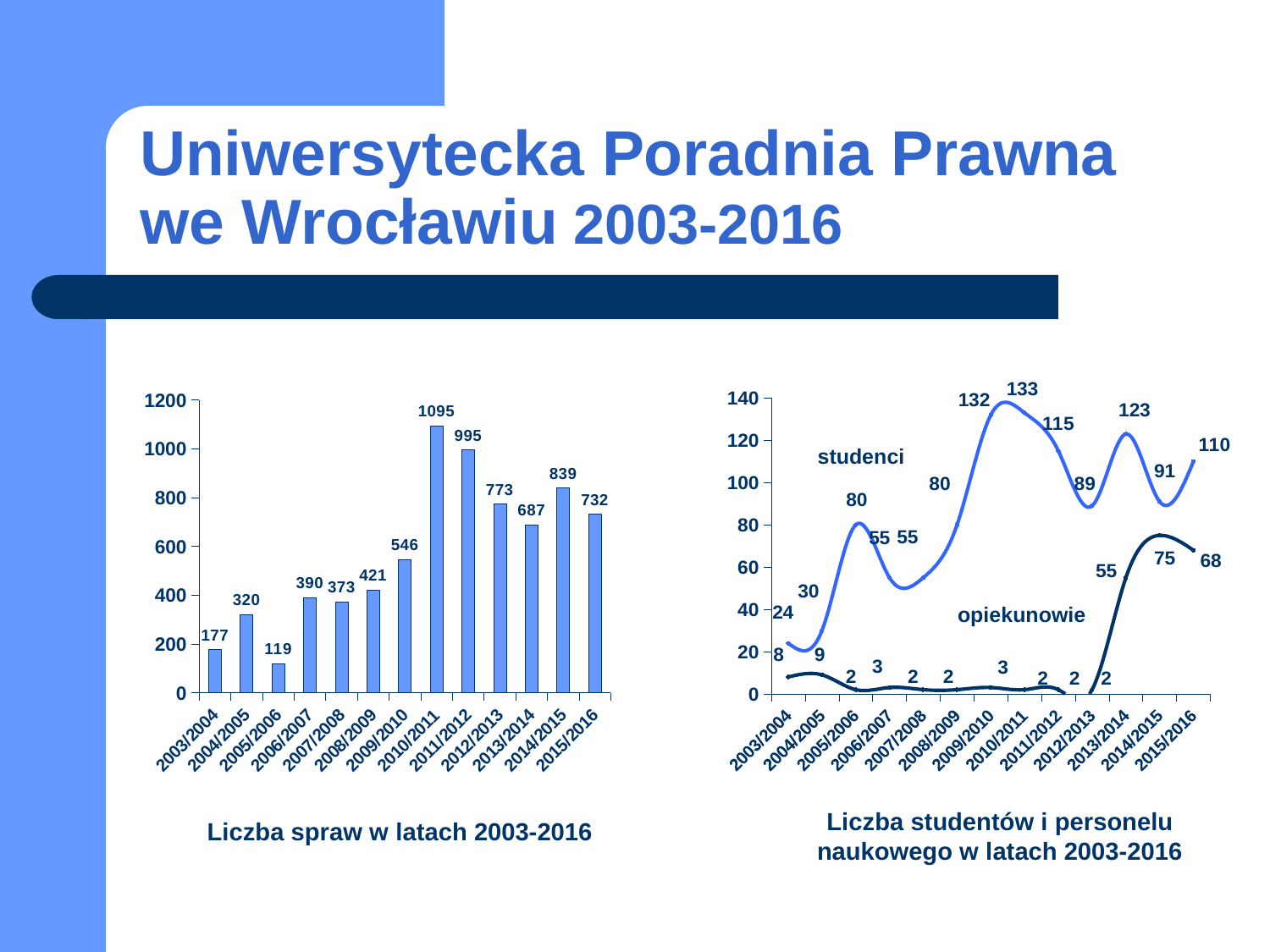
In the right chart (Liczba studentów i personelu naukowego), what is the value for opiekunowie in 2014/2015? 75 What kind of chart is the right chart (Liczba studentów i personelu naukowego)? line chart In the left chart (Liczba spraw w latach 2003-2016), which year has the highest number of cases? 2010/2011 In the right chart (Liczba studentów i personelu naukowego), what is the value for studenci in 2009/2010? 132 What kind of chart is the left chart (Liczba spraw w latach 2003-2016)? bar chart In the right chart (Liczba studentów i personelu naukowego), in which year does the studenci series reach its highest value? 2010/2011 In the left chart (Liczba spraw w latach 2003-2016), what is the difference between the values for 2014/2015 and 2015/2016? 107 In the left chart (Liczba spraw w latach 2003-2016), how many years are shown on the x axis? 13 In the left chart (Liczba spraw w latach 2003-2016), which year has the lowest number of cases? 2005/2006 In the left chart (Liczba spraw w latach 2003-2016), what is the value for 2010/2011? 1095 In the right chart (Liczba studentów i personelu naukowego), which is larger in 2015/2016: studenci or opiekunowie? studenci In the right chart (Liczba studentów i personelu naukowego), what is the difference between studenci and opiekunowie in 2013/2014? 68